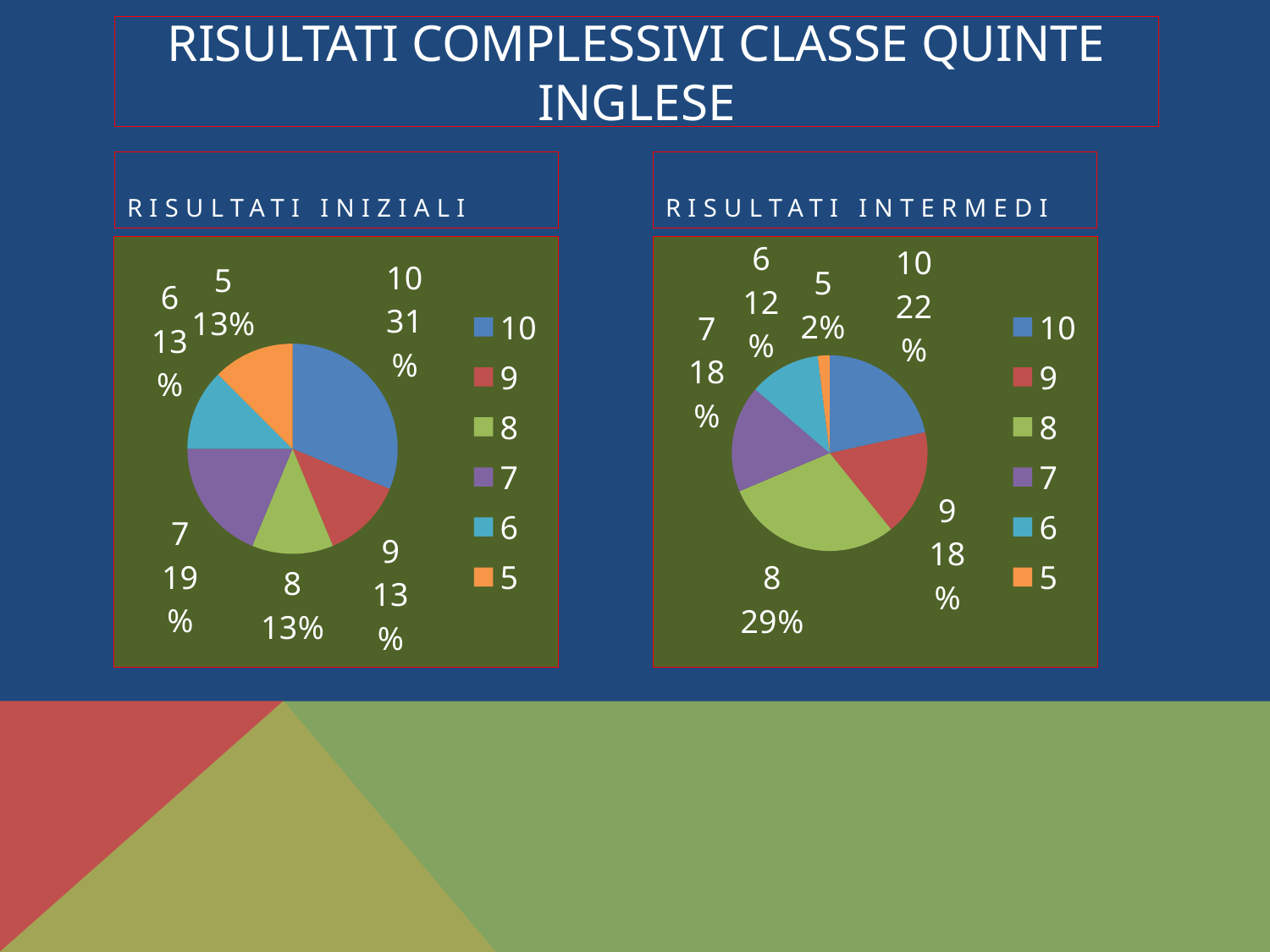
In the RISULTATI INIZIALI chart, which is larger, the slice for category 7 or the slice for category 9? 7 How many categories does the legend of the RISULTATI INTERMEDI chart list? 6 In the RISULTATI INIZIALI chart, which category has the largest slice? 10 In the RISULTATI INTERMEDI chart, what is the difference in percentage points between category 10 and category 6? 10 percentage points In the RISULTATI INIZIALI chart, what colour is the slice for category 5? Orange What type of chart is the RISULTATI INIZIALI chart? Pie chart In the RISULTATI INIZIALI chart, what share of the pie does category 7 have? 19% In the RISULTATI INIZIALI chart, what share of the pie does category 10 have? 31% In the RISULTATI INTERMEDI chart, which category has the smallest slice? 5 In the RISULTATI INTERMEDI chart, what share of the pie does category 5 have? 2% In the RISULTATI INTERMEDI chart, which category has the largest slice? 8